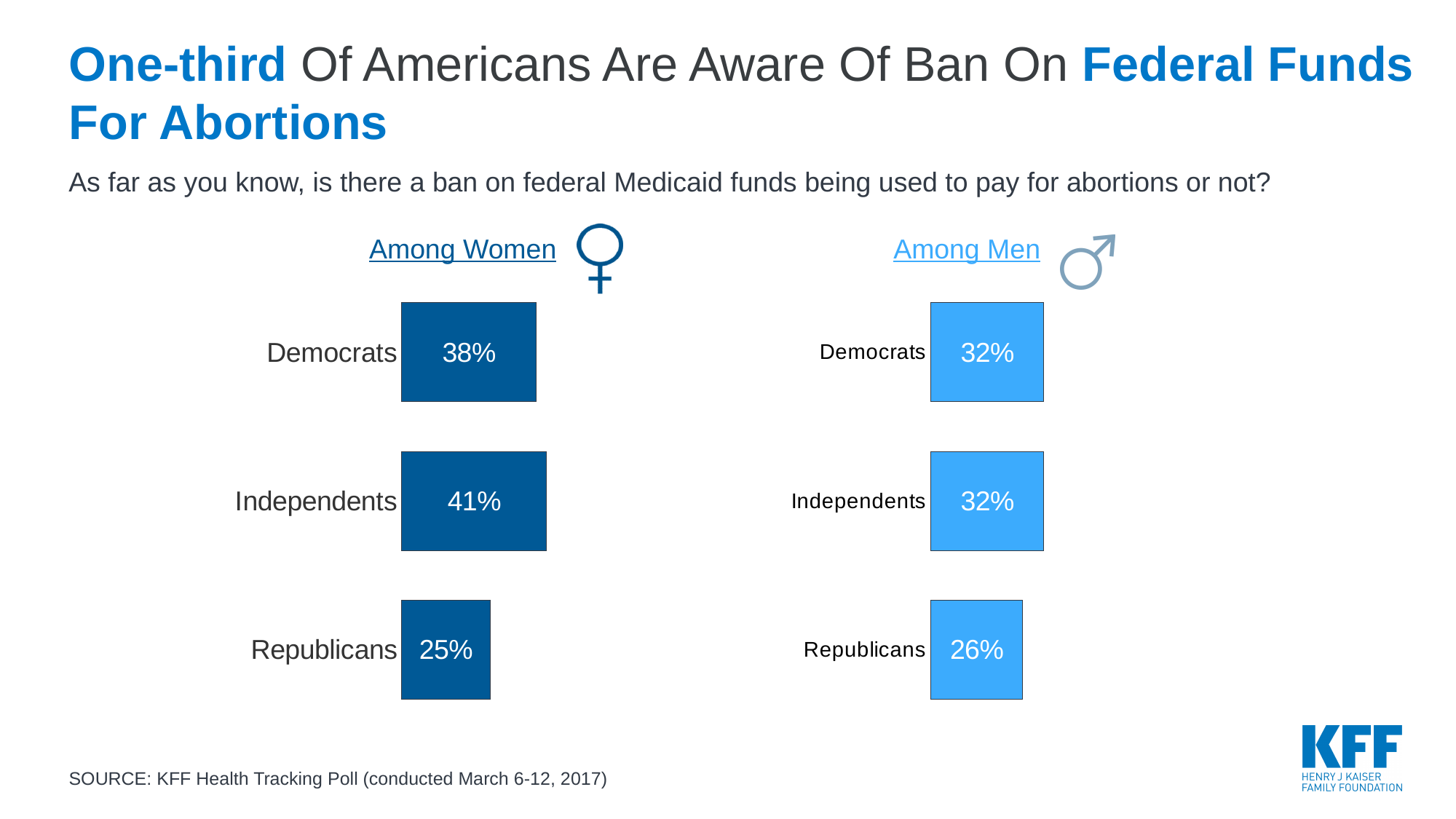
In the Among Men chart, which group has the lowest value? Republicans In the Among Women chart, what is the value for Independents? 41% In the Among Men chart, what is the value for Democrats? 32% What kind of chart is the Among Women chart? Bar chart In the Among Women chart, which group has the lowest value? Republicans In the Among Women chart, what percentage of Democrats are aware of the ban? 38% In the Among Women chart, what is the difference between the values for Independents and Republicans? 16 percentage points Which is larger: the value for Democrats among women or the value for Democrats among men? Democrats among women How many groups are shown in the Among Men chart? 3 What is the difference between the Republicans value among men and the Republicans value among women? 1 percentage point In the Among Men chart, what is the value for Republicans? 26% In the Among Women chart, which group has the highest value? Independents